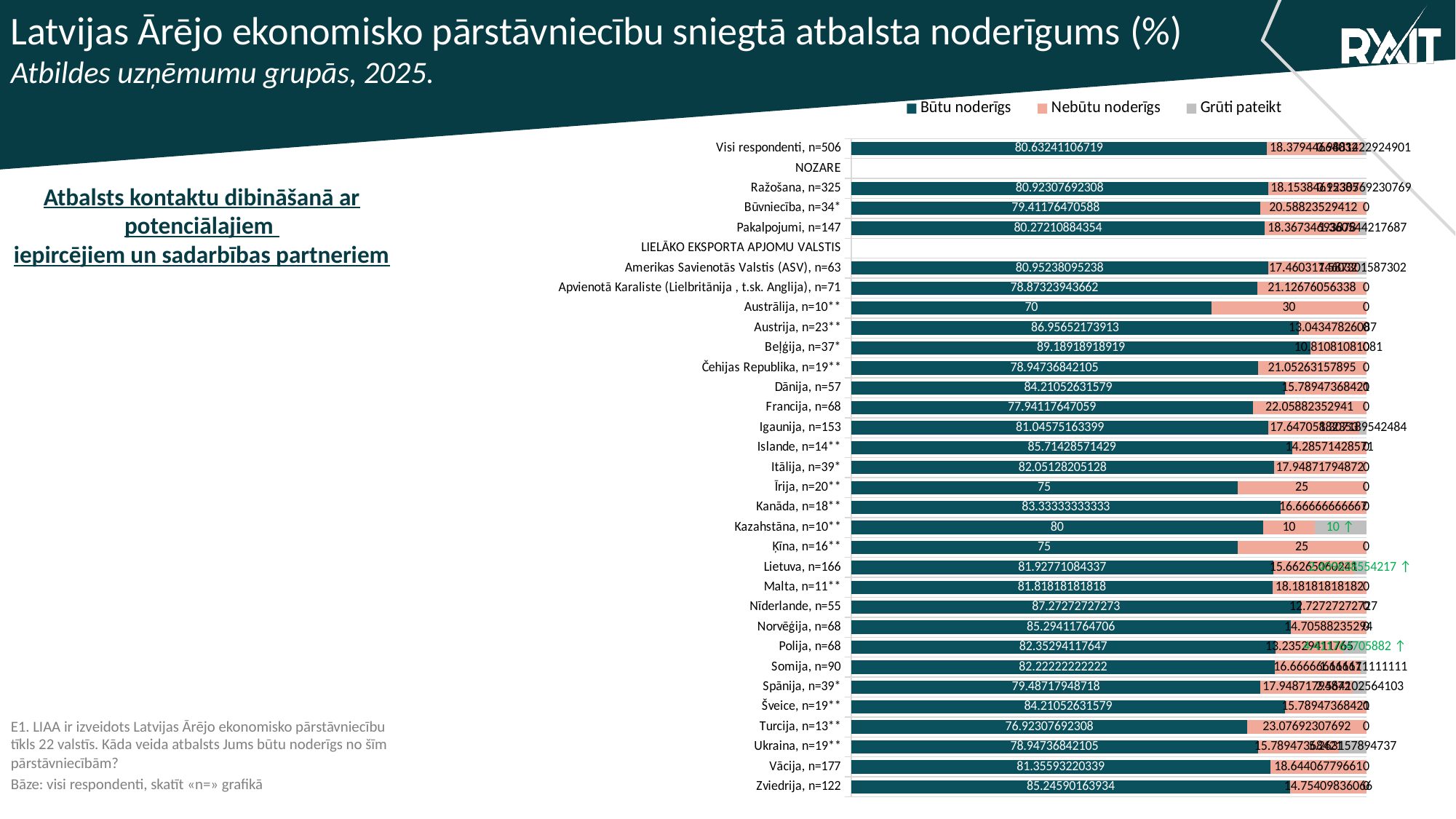
What is the 'Nebūtu noderīgs' value for Ķīna, n=16**? 25 What kind of chart is shown on the slide? Stacked horizontal bar chart Which category has the lowest 'Būtu noderīgs' value? Austrālija, n=10** Which category has the highest 'Būtu noderīgs' value? Beļģija, n=37* What is the 'Nebūtu noderīgs' value for Austrālija, n=10**? 30 What is the 'Grūti pateikt' value for Kazahstāna, n=10**? 10 What is the 'Būtu noderīgs' value for Austrālija, n=10**? 70 Which has a larger 'Būtu noderīgs' value: Nīderlande, n=55 or Turcija, n=13**? Nīderlande, n=55 What is the difference between the 'Būtu noderīgs' values for Kazahstāna, n=10** and Austrālija, n=10**? 10 Which legend entry is shown in grey? Grūti pateikt How many series does the legend list? 3 What is the 'Būtu noderīgs' value for Beļģija, n=37*? 89.18918918919